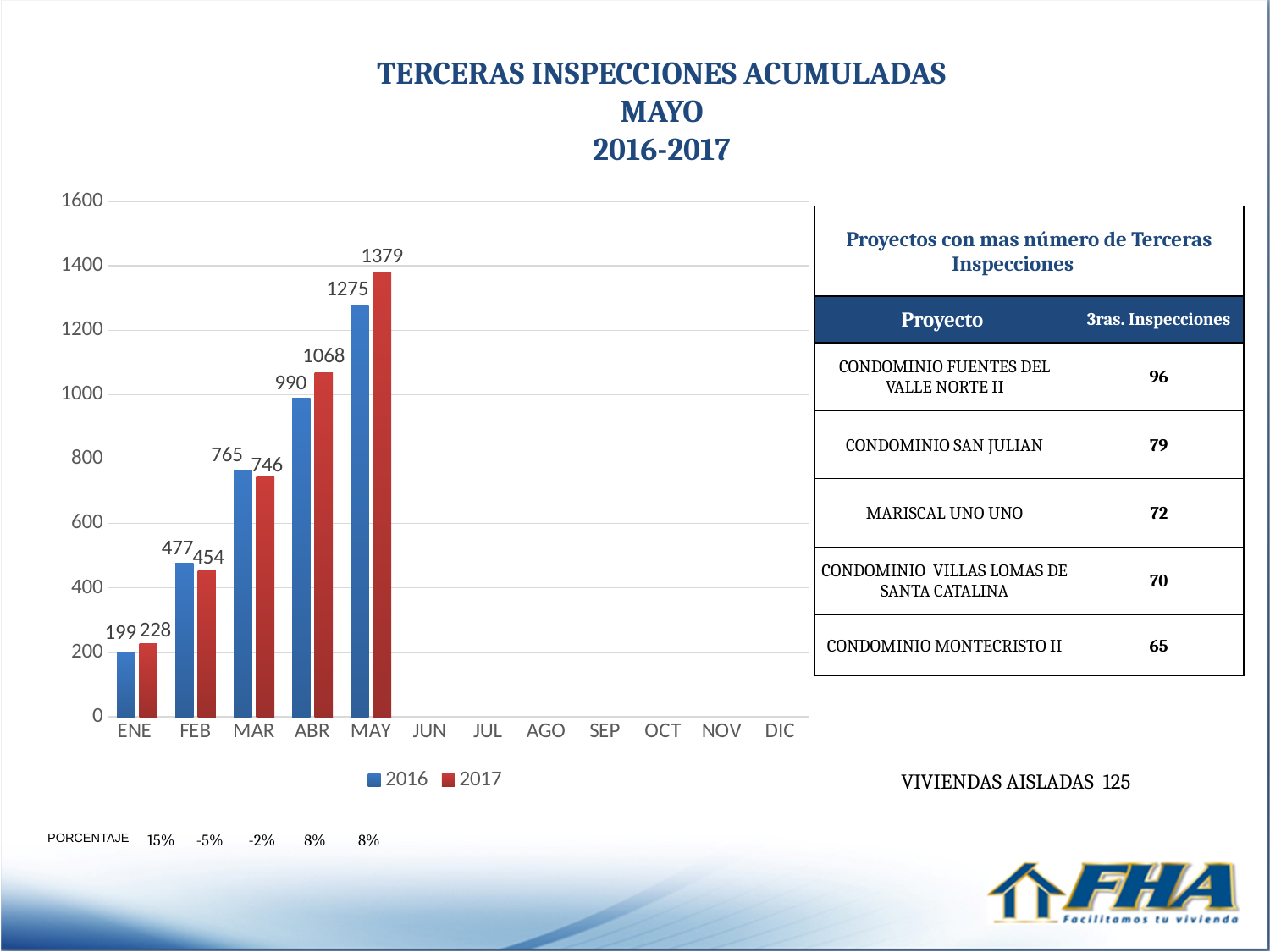
What kind of chart is shown on the slide? bar chart Is the 2016 value for MAY greater or less than 1200? greater How many months have bars plotted with data? 5 What is the value for 2017 in MAY? 1379 Do the 2017 values rise or fall from ENE to MAY? rise Which is larger in FEB, the 2016 value or the 2017 value? 2016 What is the value for 2016 in MAR? 765 What is the value for 2017 in ENE? 228 Which month has the highest value for the 2016 series? MAY How many series does the legend list? 2 Which month has the lowest value for the 2017 series among the months with data? ENE What is the difference between the 2017 and 2016 values in ABR? 78